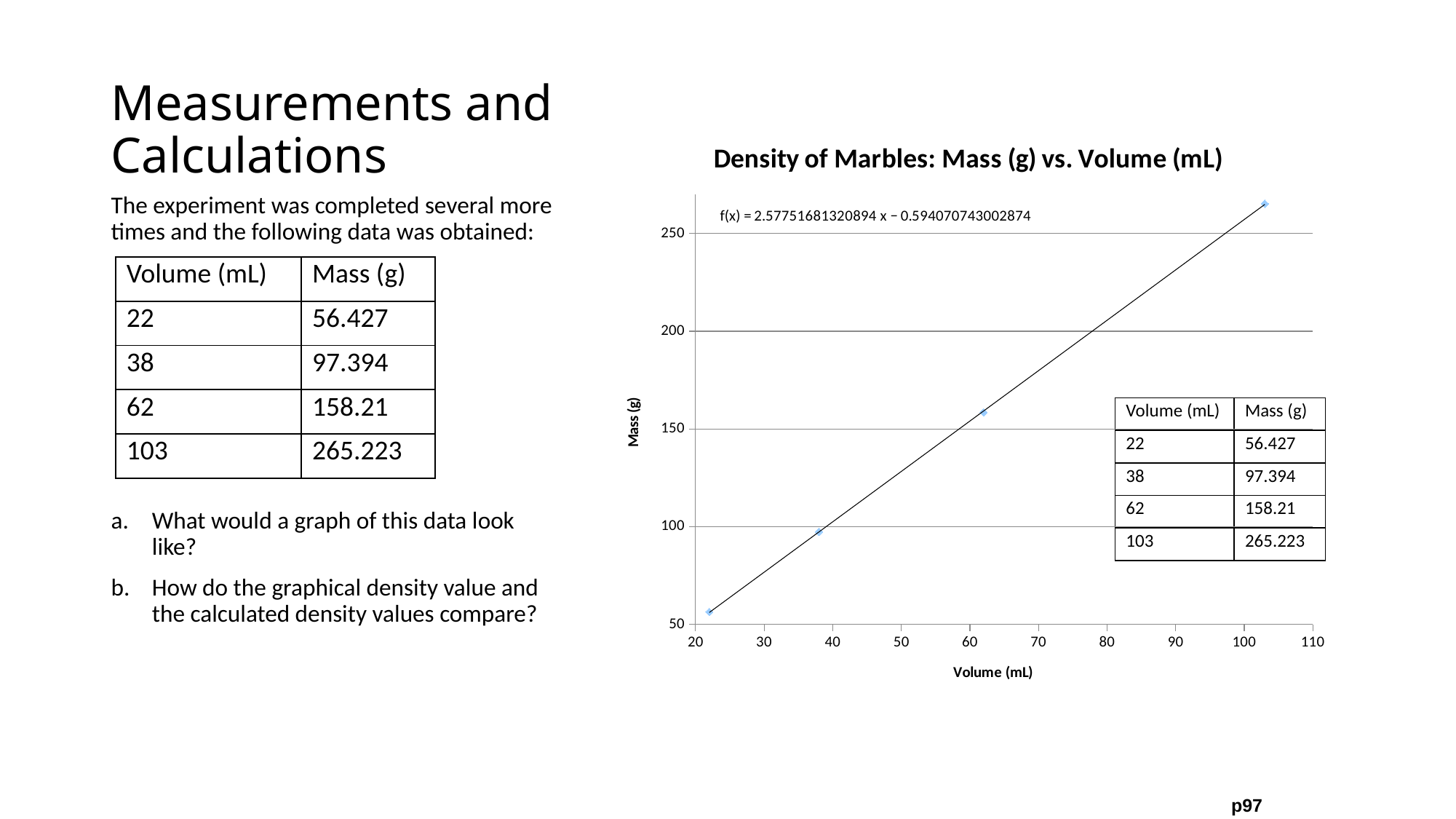
What kind of chart is shown on the slide? scatter chart What is the mass (g) at a volume of 103 mL? 265.223 Which volume has the lowest mass? 22 Which has a larger mass, the 62 mL point or the 38 mL point? 62 mL What is the title of the chart? Density of Marbles: Mass (g) vs. Volume (mL) What is the mass (g) at a volume of 22 mL? 56.427 Is the mass at 62 mL greater or less than 150? greater Does mass rise or fall as volume increases along the x axis? rise What is the mass (g) at a volume of 62 mL? 158.21 How many data points are plotted on the chart? 4 What is the difference in mass between the 38 mL and 22 mL points? 40.967 Which volume has the highest mass? 103